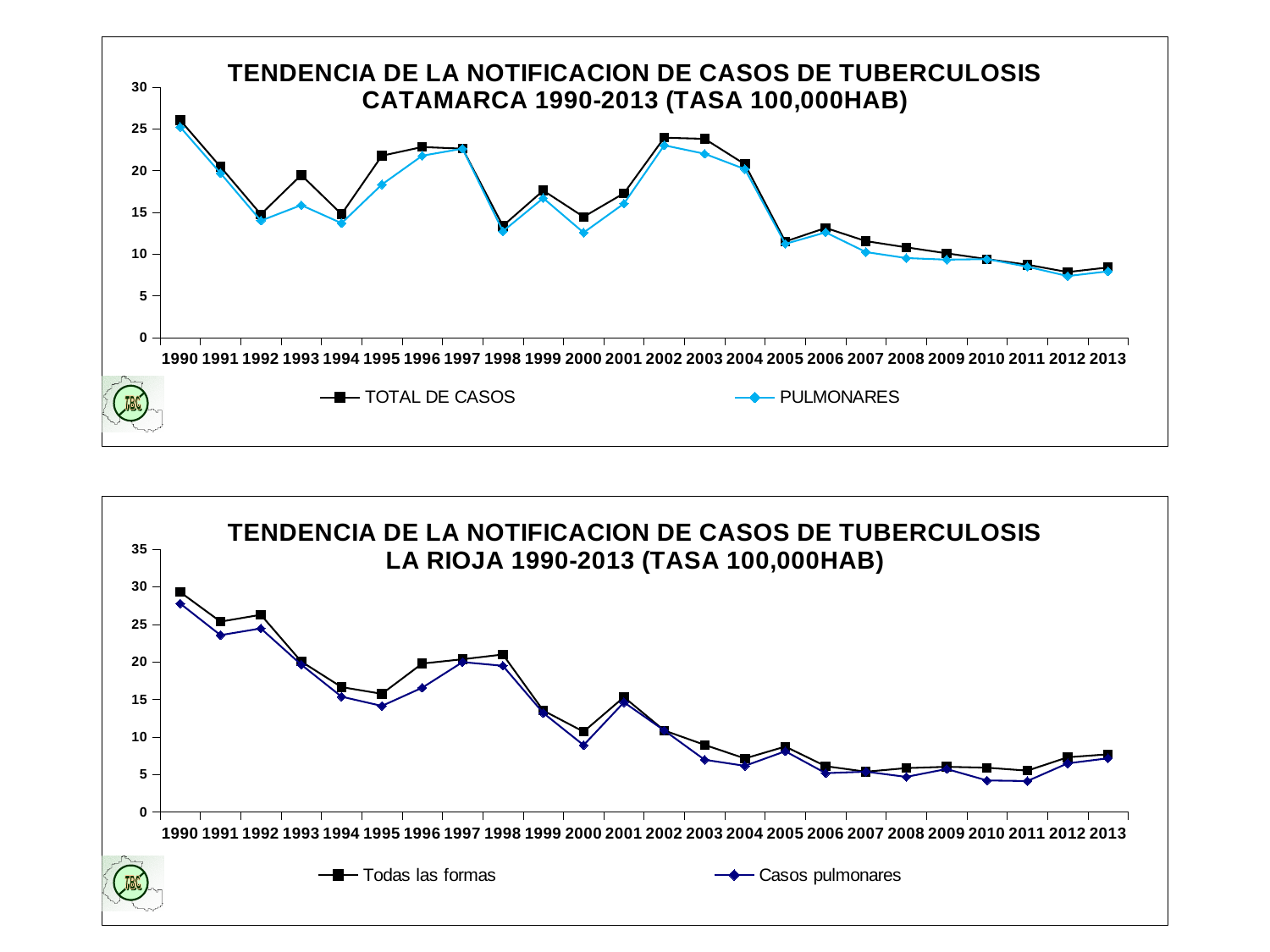
In the Catamarca chart, is TOTAL DE CASOS higher in 1990 or in 2013? 1990 In the Catamarca chart, in which year is TOTAL DE CASOS highest? 1990 In the La Rioja chart, is the Casos pulmonares value for 2000 greater or less than 10? less In the Catamarca chart, how many years are shown on the x axis? 24 In the Catamarca chart, how many series does the legend list? 2 What kind of chart is the top chart (Catamarca)? Line chart In the La Rioja chart, do the Todas las formas values overall rise or fall from 1990 to 2013? Fall In the Catamarca chart, is the PULMONARES value for 2000 greater or less than 15? less In the La Rioja chart, what are the two legend entries? Todas las formas and Casos pulmonares In the Catamarca chart, is the TOTAL DE CASOS value for 1993 greater or less than 15? greater In the La Rioja chart, in which year is Todas las formas highest? 1990